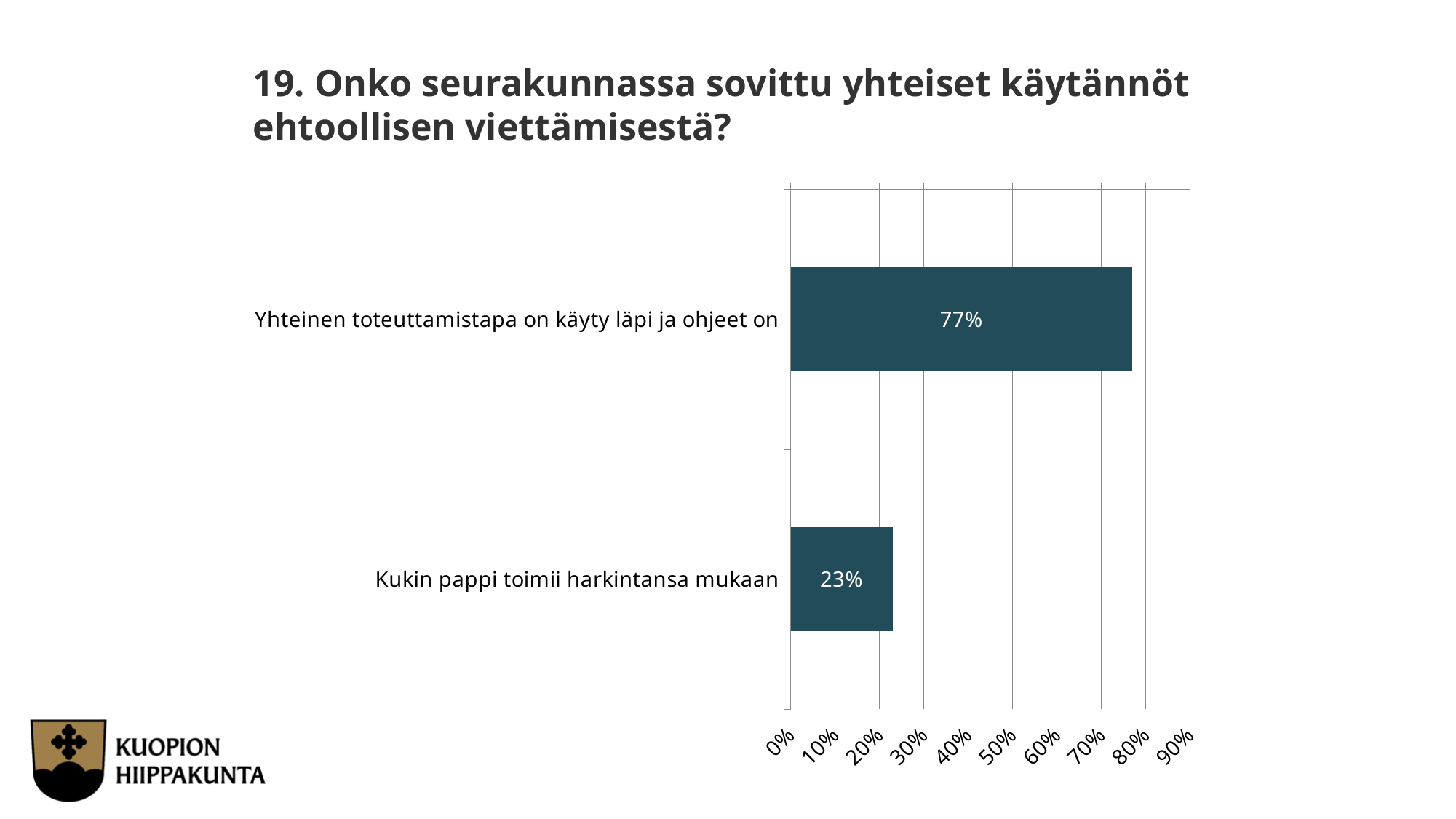
Which category has the lowest value? Kukin pappi toimii harkintansa mukaan What is the value for "Yhteinen toteuttamistapa on käyty läpi ja ohjeet on"? 77% What kind of chart is shown on the slide? Bar chart Is the value for "Yhteinen toteuttamistapa on käyty läpi ja ohjeet on" greater or less than 70%? greater Is the value for "Kukin pappi toimii harkintansa mukaan" greater or less than 30%? less Which is larger: the value for "Kukin pappi toimii harkintansa mukaan" or the value for "Yhteinen toteuttamistapa on käyty läpi ja ohjeet on"? Yhteinen toteuttamistapa on käyty läpi ja ohjeet on What is the title of the slide? 19. Onko seurakunnassa sovittu yhteiset käytännöt ehtoollisen viettämisestä? Which category has the highest value? Yhteinen toteuttamistapa on käyty läpi ja ohjeet on What is the value for "Kukin pappi toimii harkintansa mukaan"? 23% What is the highest value shown on the x axis? 90% What is the difference between the values for "Yhteinen toteuttamistapa on käyty läpi ja ohjeet on" and "Kukin pappi toimii harkintansa mukaan"? 54% How many categories are shown in the chart? 2